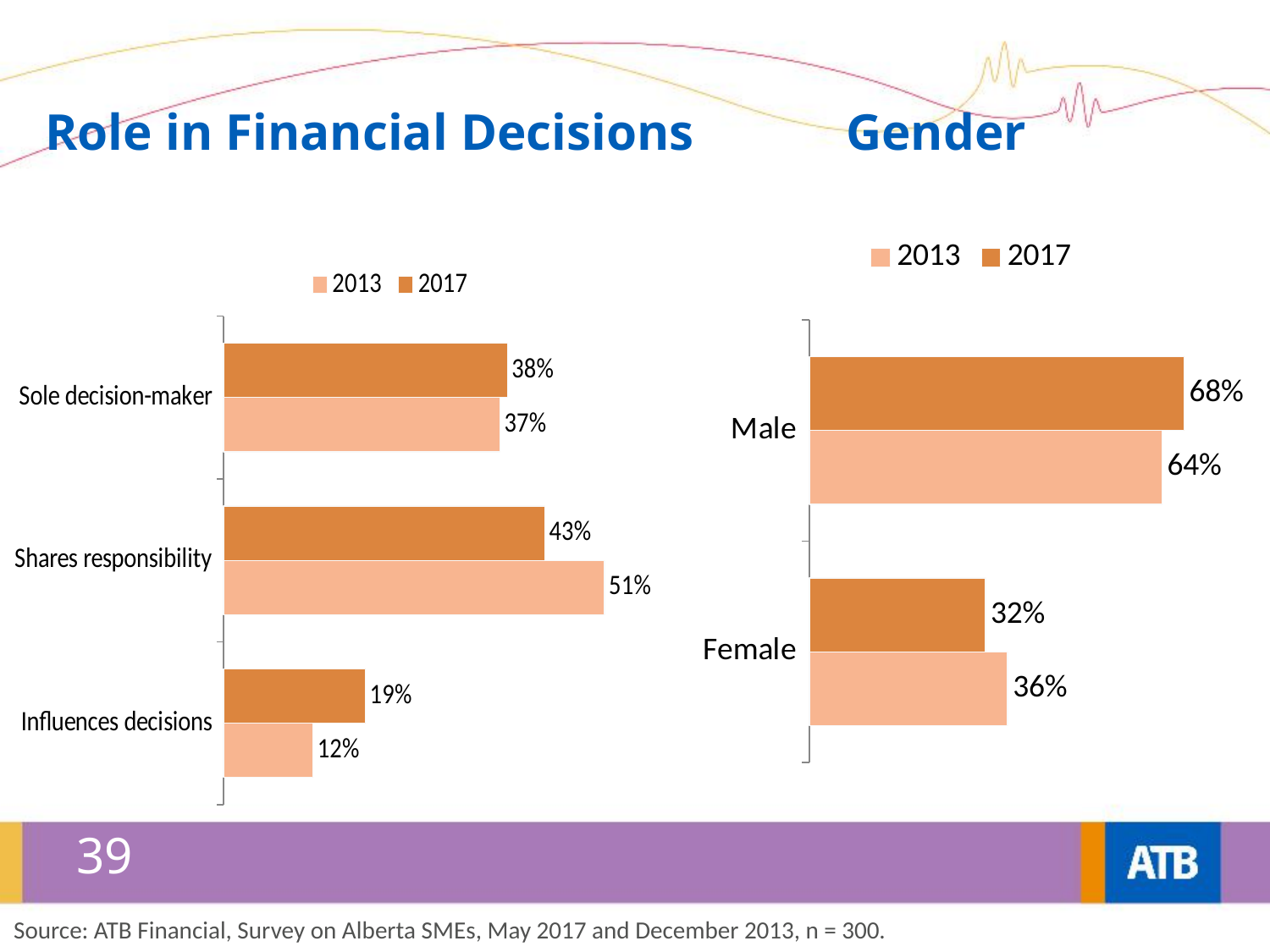
In the Role in Financial Decisions chart, what is the 2017 value for Sole decision-maker? 38% In the Role in Financial Decisions chart, how many categories are shown? 3 In the Gender chart, what is the difference between the 2017 and 2013 values for Male? 4% In the Gender chart, what is the 2013 value for Female? 36% In the Role in Financial Decisions chart, what is the difference between the 2013 and 2017 values for Shares responsibility? 8% In the Role in Financial Decisions chart, what is the 2013 value for Influences decisions? 12% In the Role in Financial Decisions chart, what is the 2013 value for Shares responsibility? 51% In the Gender chart, what is the 2017 value for Male? 68% In the Gender chart, which is larger: the 2013 value for Female or the 2017 value for Female? 2013 How many series does the legend of the Gender chart list? 2 What type of chart is the Gender chart? Bar chart In the Role in Financial Decisions chart, which category has the highest 2017 value? Shares responsibility